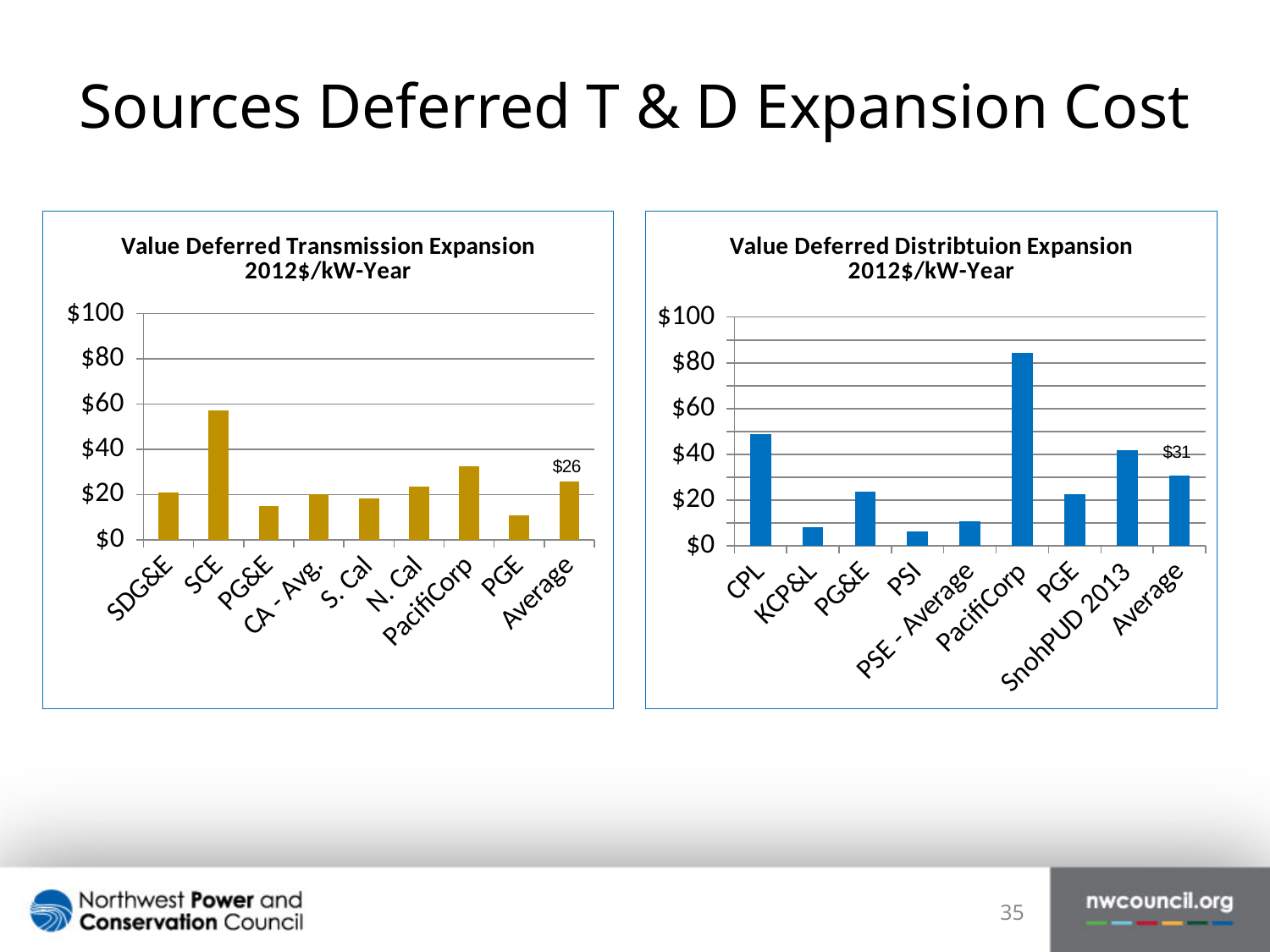
On the Value Deferred Transmission Expansion chart, what is the value for Average? $26 How many categories are shown on the Value Deferred Distribtuion Expansion chart? 9 On the Value Deferred Distribtuion Expansion chart, which is larger, CPL or PGE? CPL On the Value Deferred Distribtuion Expansion chart, what is the value for Average? $31 On the Value Deferred Distribtuion Expansion chart, is the value for KCP&L greater or less than $20? less On the Value Deferred Transmission Expansion chart, is the value for SCE greater or less than $40? greater On the Value Deferred Distribtuion Expansion chart, is the value for PacifiCorp greater or less than $80? greater On the Value Deferred Distribtuion Expansion chart, which category has the highest value? PacifiCorp On the Value Deferred Transmission Expansion chart, which category has the highest value? SCE On the Value Deferred Transmission Expansion chart, which category has the lowest value? PGE What type of chart is the Value Deferred Transmission Expansion chart? Bar chart On the Value Deferred Transmission Expansion chart, which is larger, SCE or SDG&E? SCE